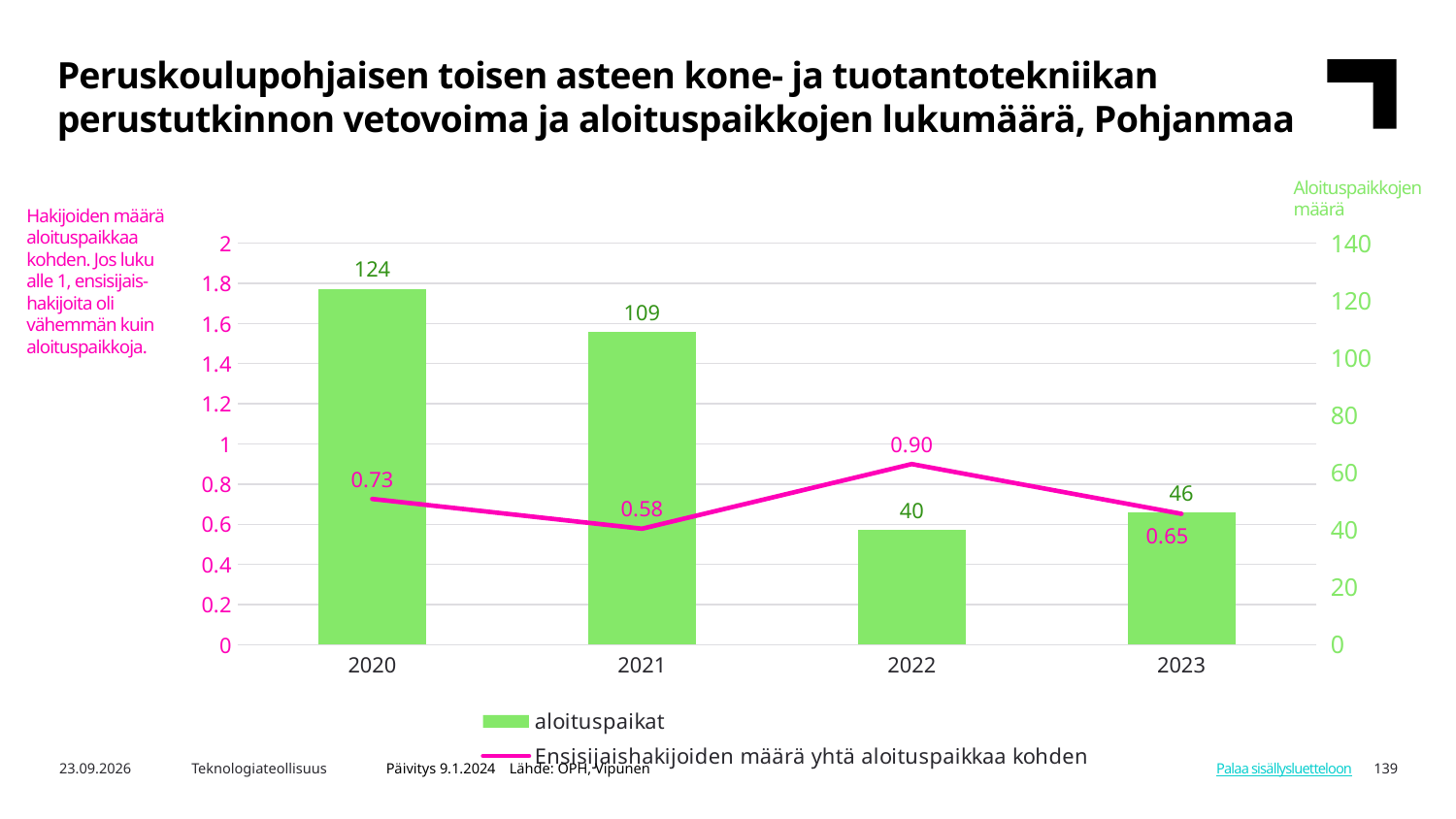
What is the value of aloituspaikat for 2022? 40 What is the difference in aloituspaikat between 2020 and 2021? 15 How many series does the legend list? 2 How many years are shown on the x axis? 4 Which year has the lowest value of Ensisijaishakijoiden määrä yhtä aloituspaikkaa kohden? 2021 What colour are the aloituspaikat bars? green Does the value of aloituspaikat rise or fall from 2021 to 2022? fall What is the value of Ensisijaishakijoiden määrä yhtä aloituspaikkaa kohden for 2021? 0.58 Which year has the highest value of aloituspaikat? 2020 What is the value of aloituspaikat for 2020? 124 Which year has the larger value of aloituspaikat, 2022 or 2023? 2023 What is the value of Ensisijaishakijoiden määrä yhtä aloituspaikkaa kohden for 2023? 0.65